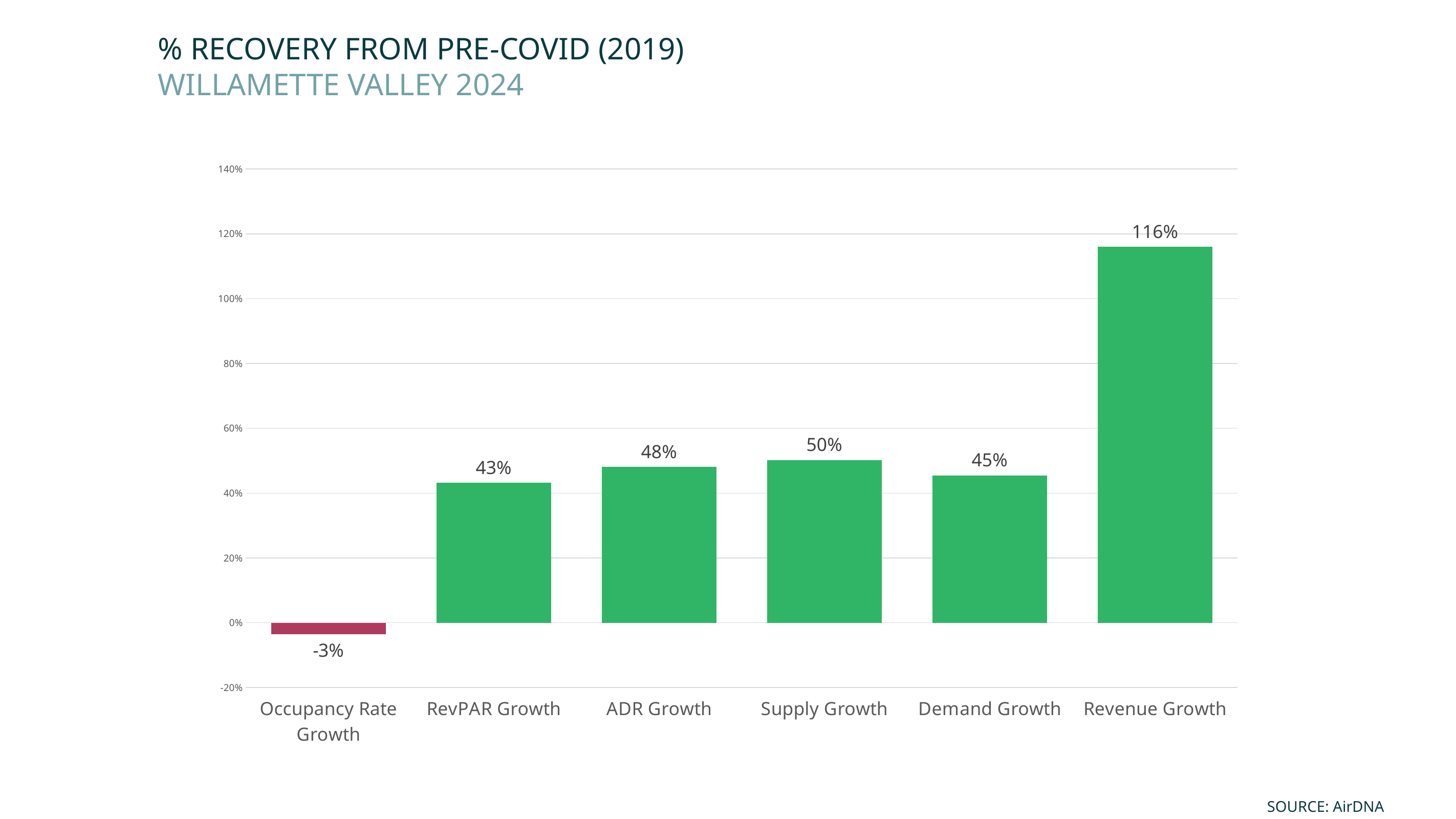
What is the value for Revenue Growth? 116% What is the difference between ADR Growth and RevPAR Growth? 5% What is the difference between Revenue Growth and Supply Growth? 66% What is the value for ADR Growth? 48% Which category has the highest value? Revenue Growth How many categories are shown on the chart? 6 What is the value for Occupancy Rate Growth? -3% Which category has the lowest value? Occupancy Rate Growth Is the value for Revenue Growth greater or less than 100%? greater What is the value for Demand Growth? 45% What kind of chart is shown on the slide? Bar chart Which is larger, Supply Growth or Demand Growth? Supply Growth